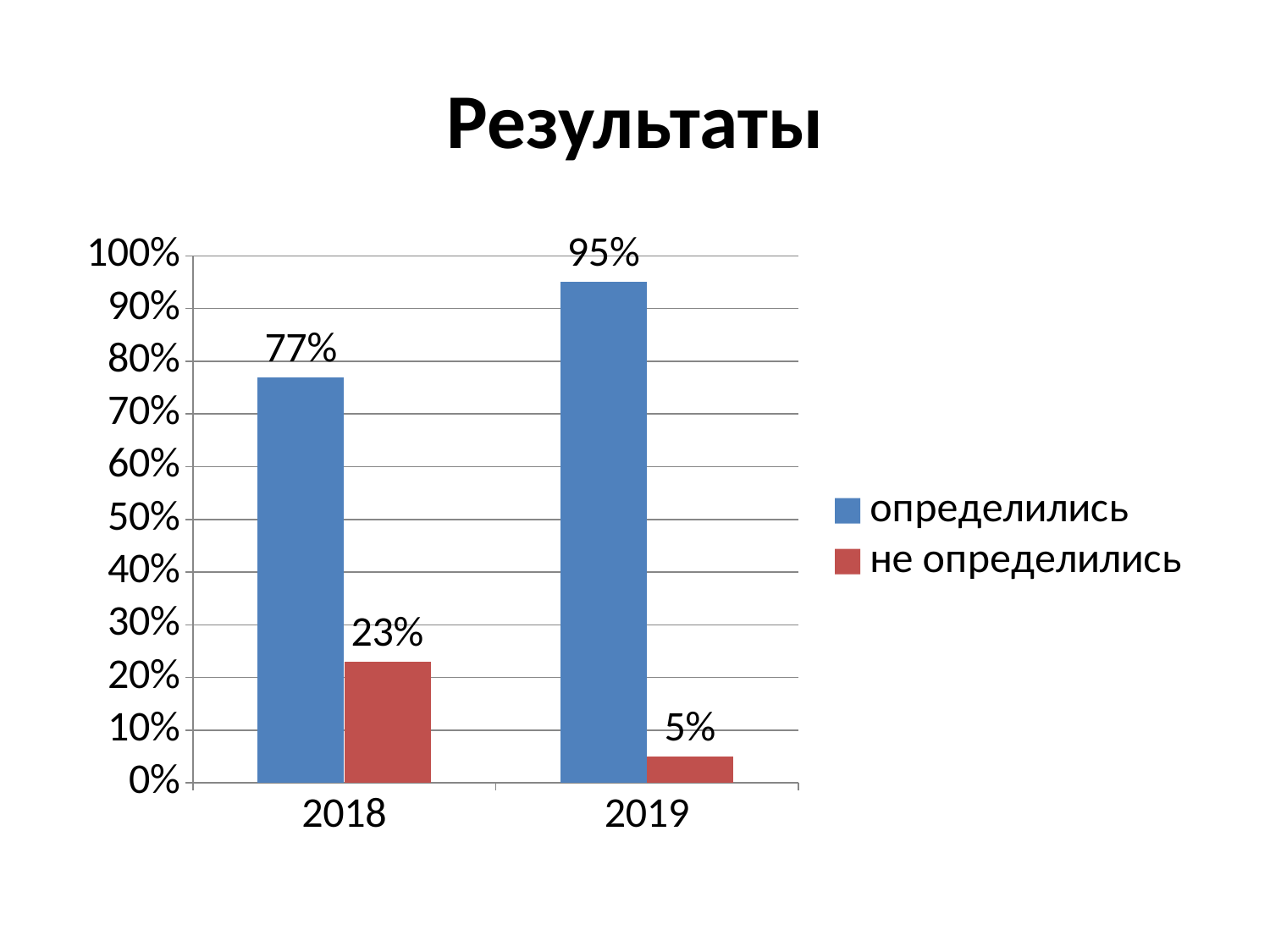
What kind of chart is shown on the slide? bar chart Is the value for "не определились" in 2018 larger or smaller than the value for "определились" in 2018? smaller What is the value for "определились" in 2019? 95% Which year has the lower value for "не определились"? 2019 What is the difference between the "определились" values for 2019 and 2018? 18% What is the value for "не определились" in 2019? 5% How many series does the legend list? 2 What is the difference between the "не определились" values for 2018 and 2019? 18% What is the value for "определились" in 2018? 77% What is the title of the slide? Результаты What is the value for "не определились" in 2018? 23% Which year has the higher value for "определились"? 2019